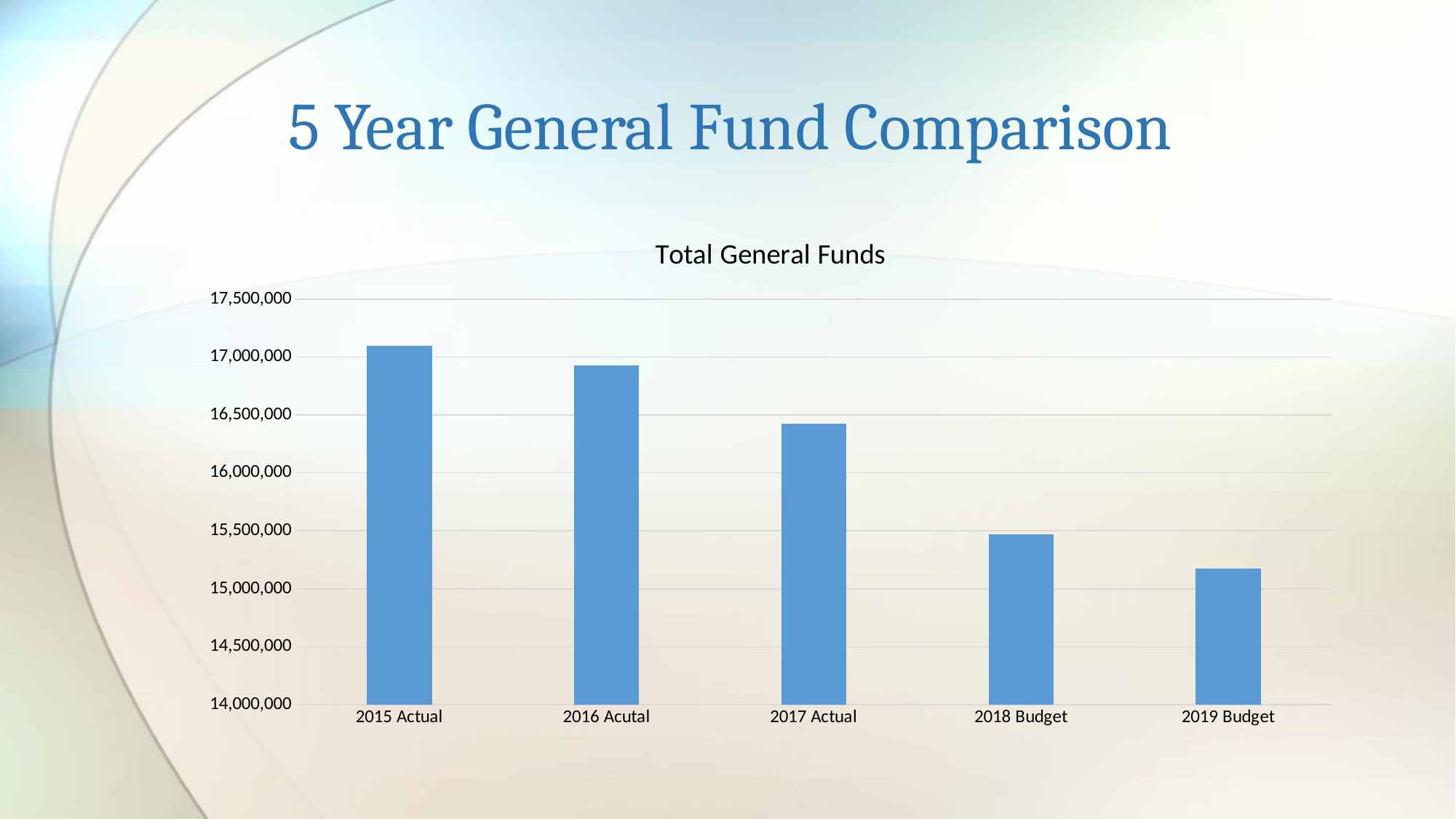
Is the value for 2017 Actual greater or less than 16,500,000? less Which category has the lowest value? 2019 Budget What is the title of the chart? Total General Funds Is the value for 2015 Actual greater or less than 17,000,000? greater Which category has the highest value? 2015 Actual Which is larger, the value for 2016 Acutal or the value for 2017 Actual? 2016 Acutal How many categories are plotted on the chart? 5 Do the values rise or fall from 2015 Actual to 2019 Budget? fall Is the value for 2016 Acutal greater or less than 17,000,000? less Which is larger, the value for 2018 Budget or the value for 2019 Budget? 2018 Budget What kind of chart is shown on the slide? bar chart